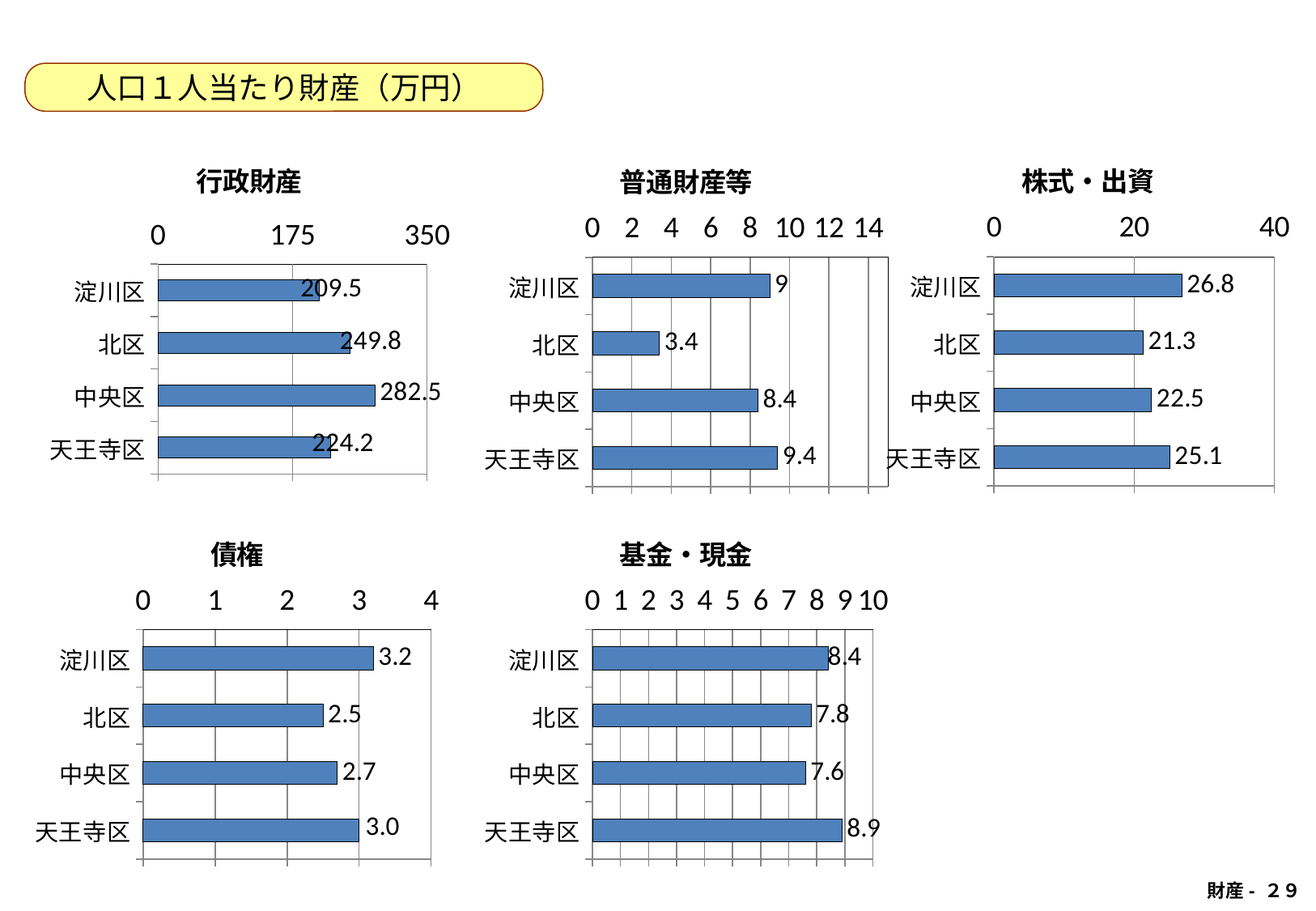
In the 基金・現金 chart, what is the difference between 天王寺区 and 北区? 1.1 What kind of chart is the 債権 chart? Bar chart In the 株式・出資 chart, which is larger, 中央区 or 天王寺区? 天王寺区 In the 普通財産等 chart, which ward has the highest value? 天王寺区 In the 基金・現金 chart, what is the value for 中央区? 7.6 In the 債権 chart, which ward has the lowest value? 北区 In the 株式・出資 chart, what is the difference between 淀川区 and 北区? 5.5 In the 普通財産等 chart, what is the value for 北区? 3.4 How many charts are shown on the slide? 5 In the 行政財産 chart, what is the value for 中央区? 282.5 In the 債権 chart, what is the value for 天王寺区? 3.0 In the 行政財産 chart, which ward has the lowest value? 淀川区